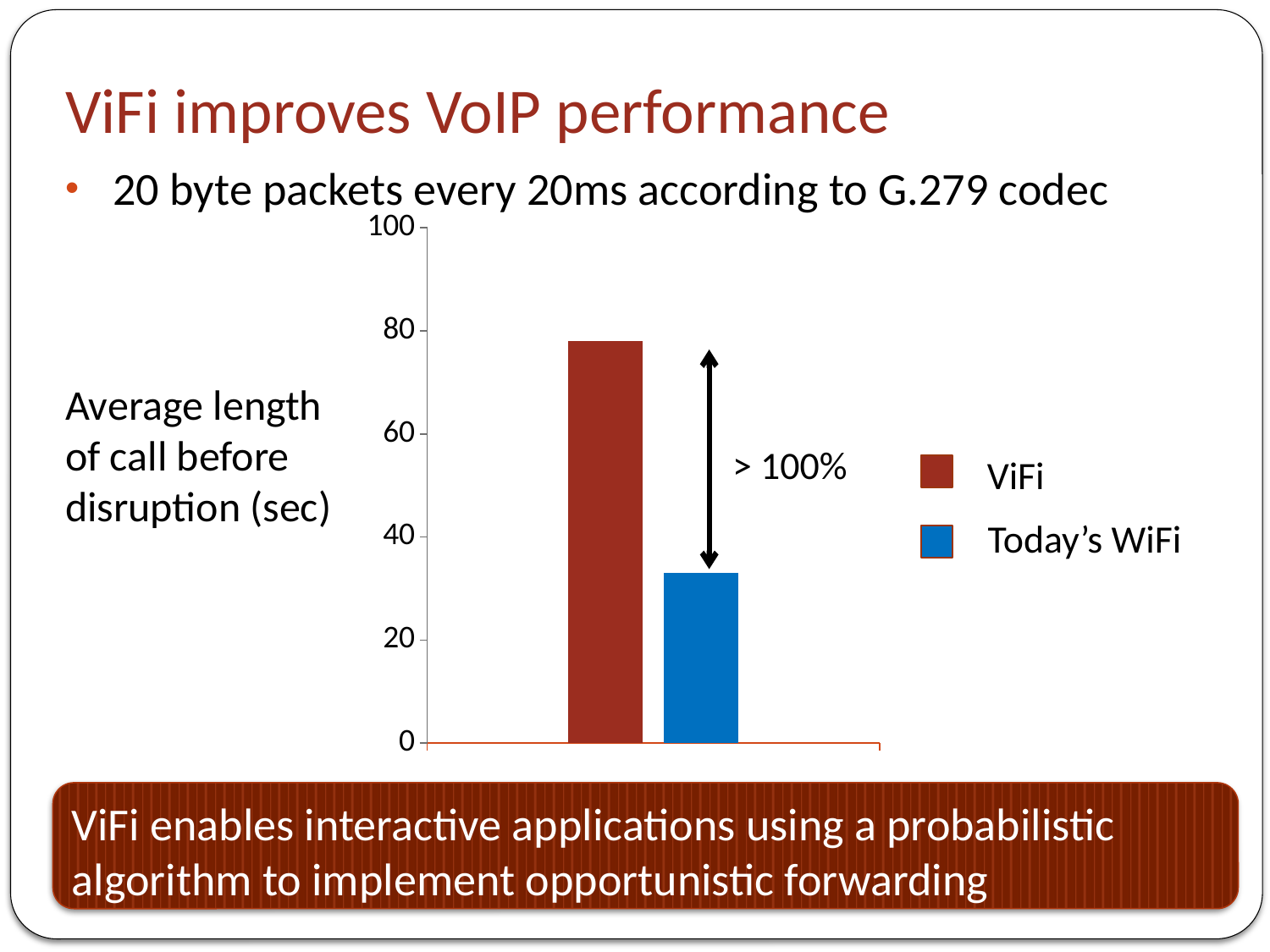
Which is larger, the value for ViFi or the value for Today's WiFi? ViFi Which series has the highest average length of call before disruption? ViFi How many series does the chart legend list? 2 How many bars are plotted in the chart? 2 Is the value for ViFi greater or less than 60? greater What kind of chart is shown on the slide? bar chart Is the value for Today's WiFi greater or less than 40? less What colour is the bar for Today's WiFi? blue Is the value for Today's WiFi greater or less than 20? greater Which series has the lowest average length of call before disruption? Today's WiFi What quantity does the vertical axis of the chart measure? Average length of call before disruption (sec)